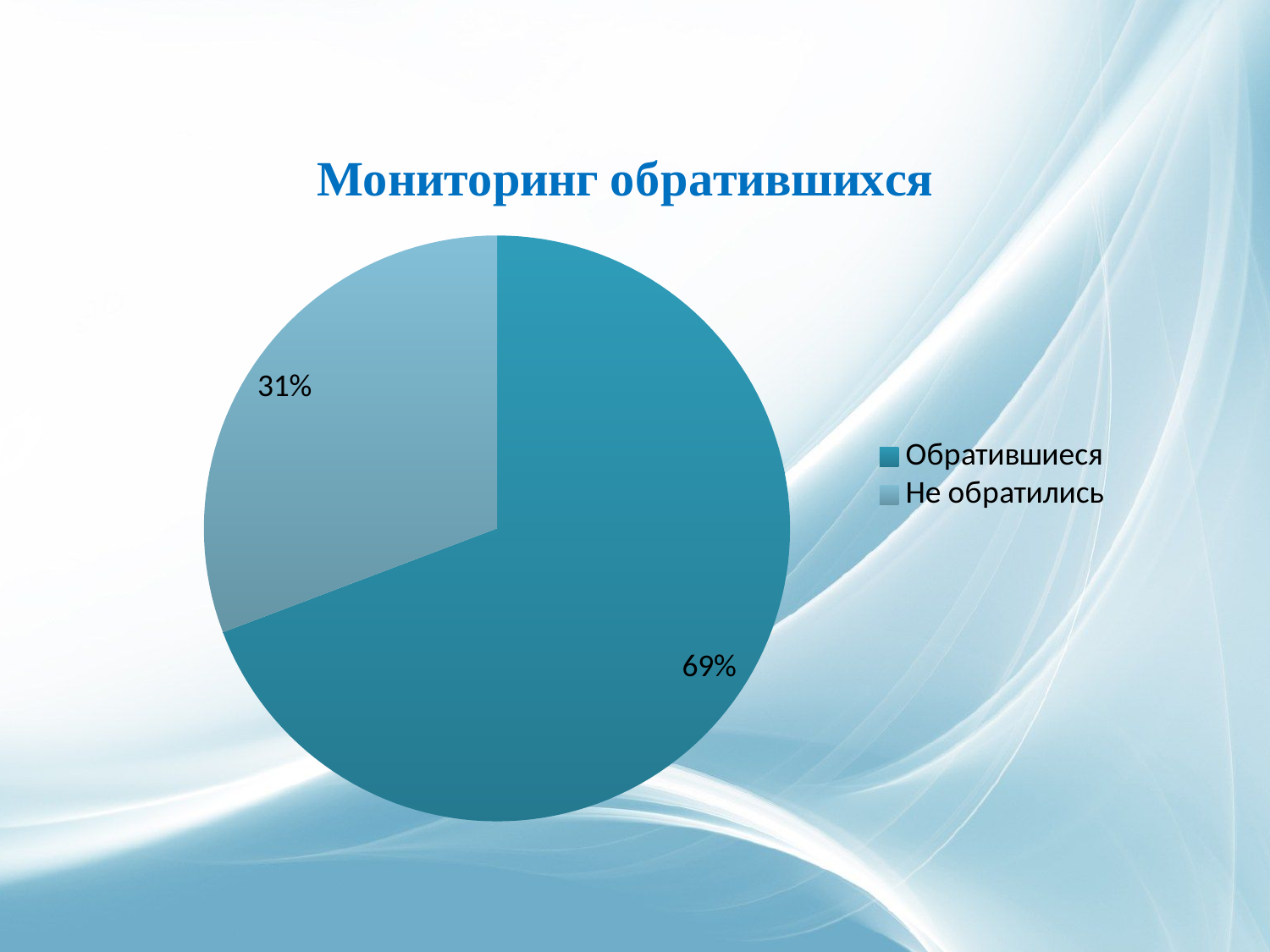
Is the share for "Обратившиеся" greater or less than 50%? greater What kind of chart is shown on the slide? pie chart What is the difference in percentage points between "Обратившиеся" and "Не обратились"? 38% Which slice is the smallest? Не обратились What share of the pie does "Обратившиеся" take? 69% Which legend entry is shown in the lighter blue colour? Не обратились Which slice is the largest? Обратившиеся How many entries does the legend list? 2 How many slices does the pie chart have? 2 What share of the pie does "Не обратились" take? 31% Which is larger, "Обратившиеся" or "Не обратились"? Обратившиеся What is the title of the chart? Мониторинг обратившихся